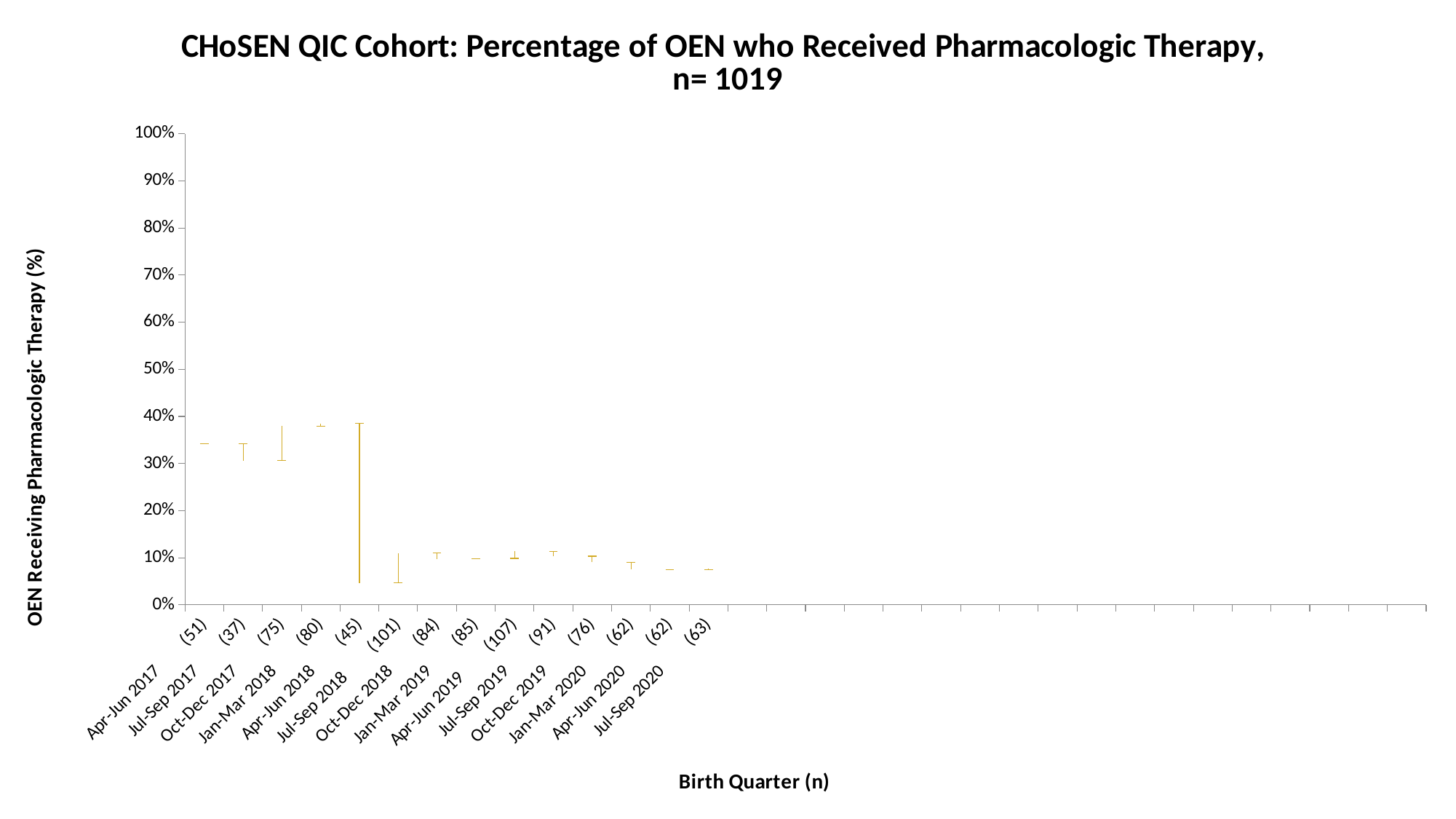
What is the label of the vertical axis? OEN Receiving Pharmacologic Therapy (%) Is the value for Jan-Mar 2018 greater or less than 30%? greater Is the value for Jul-Sep 2020 greater or less than 10%? less Is the value for Oct-Dec 2019 greater or less than 20%? less How many birth quarters are shown on the x axis? 14 Which has the larger value, Jan-Mar 2018 or Jul-Sep 2019? Jan-Mar 2018 What is the total cohort size (n) stated in the chart title? 1019 Which has the larger value, Apr-Jun 2017 or Oct-Dec 2018? Apr-Jun 2017 Do the percentages generally rise or fall from Apr-Jun 2017 to Jul-Sep 2020? fall What is the title of the chart? CHoSEN QIC Cohort: Percentage of OEN who Received Pharmacologic Therapy, n= 1019 What is the highest value shown on the vertical axis? 100%